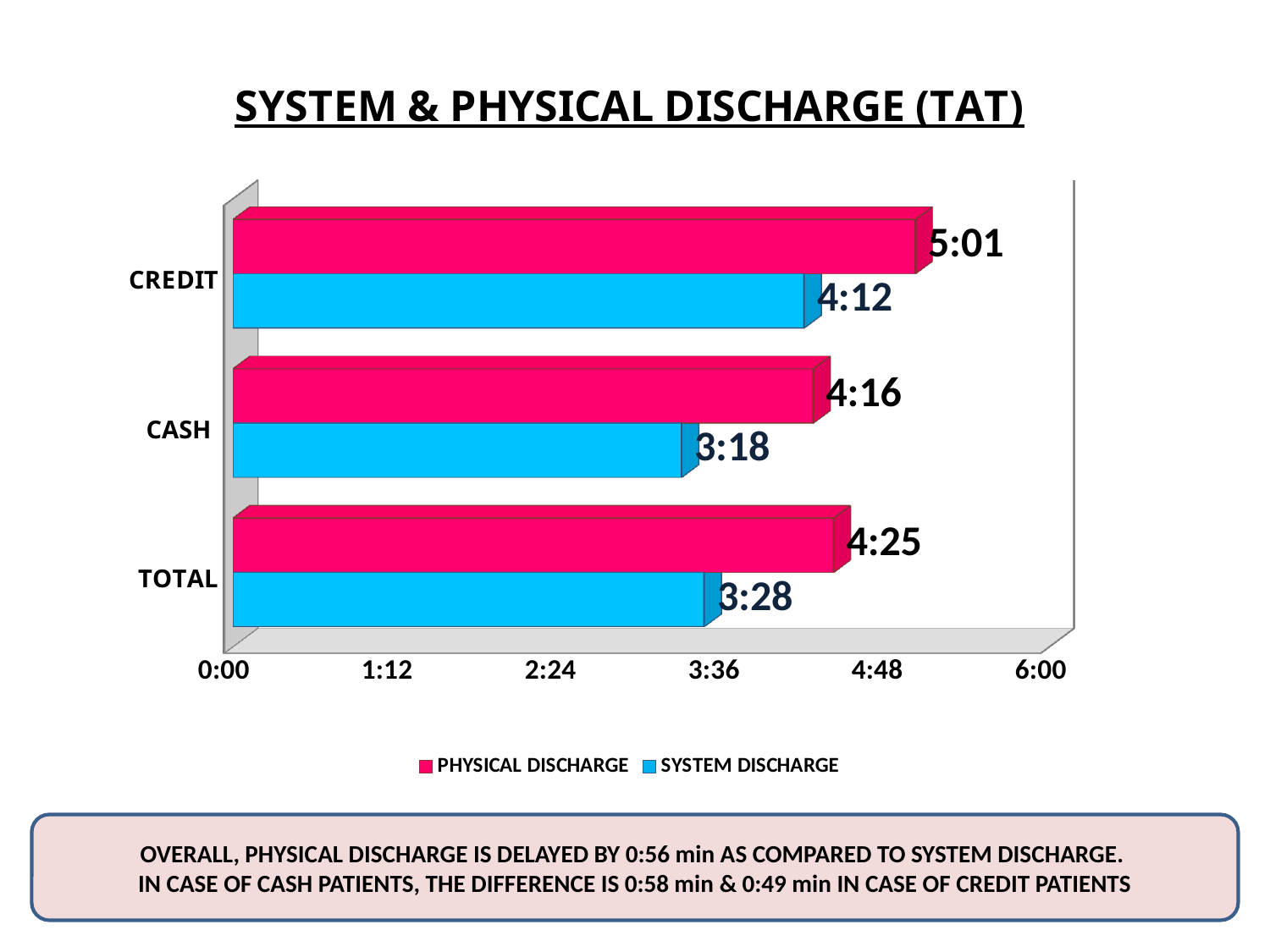
What is the SYSTEM DISCHARGE value for CASH? 3:18 What is the difference between PHYSICAL DISCHARGE and SYSTEM DISCHARGE for CREDIT? 0:49 How many categories are shown on the chart? 3 What kind of chart is shown on the slide? Bar chart What is the difference between PHYSICAL DISCHARGE and SYSTEM DISCHARGE for CASH? 0:58 Which category has the highest PHYSICAL DISCHARGE value? CREDIT Which is larger, the SYSTEM DISCHARGE value for CREDIT or the PHYSICAL DISCHARGE value for TOTAL? PHYSICAL DISCHARGE for TOTAL Which category has the lowest SYSTEM DISCHARGE value? CASH What is the PHYSICAL DISCHARGE value for CREDIT? 5:01 What is the SYSTEM DISCHARGE value for TOTAL? 3:28 What is the PHYSICAL DISCHARGE value for CASH? 4:16 How many series does the legend list? 2